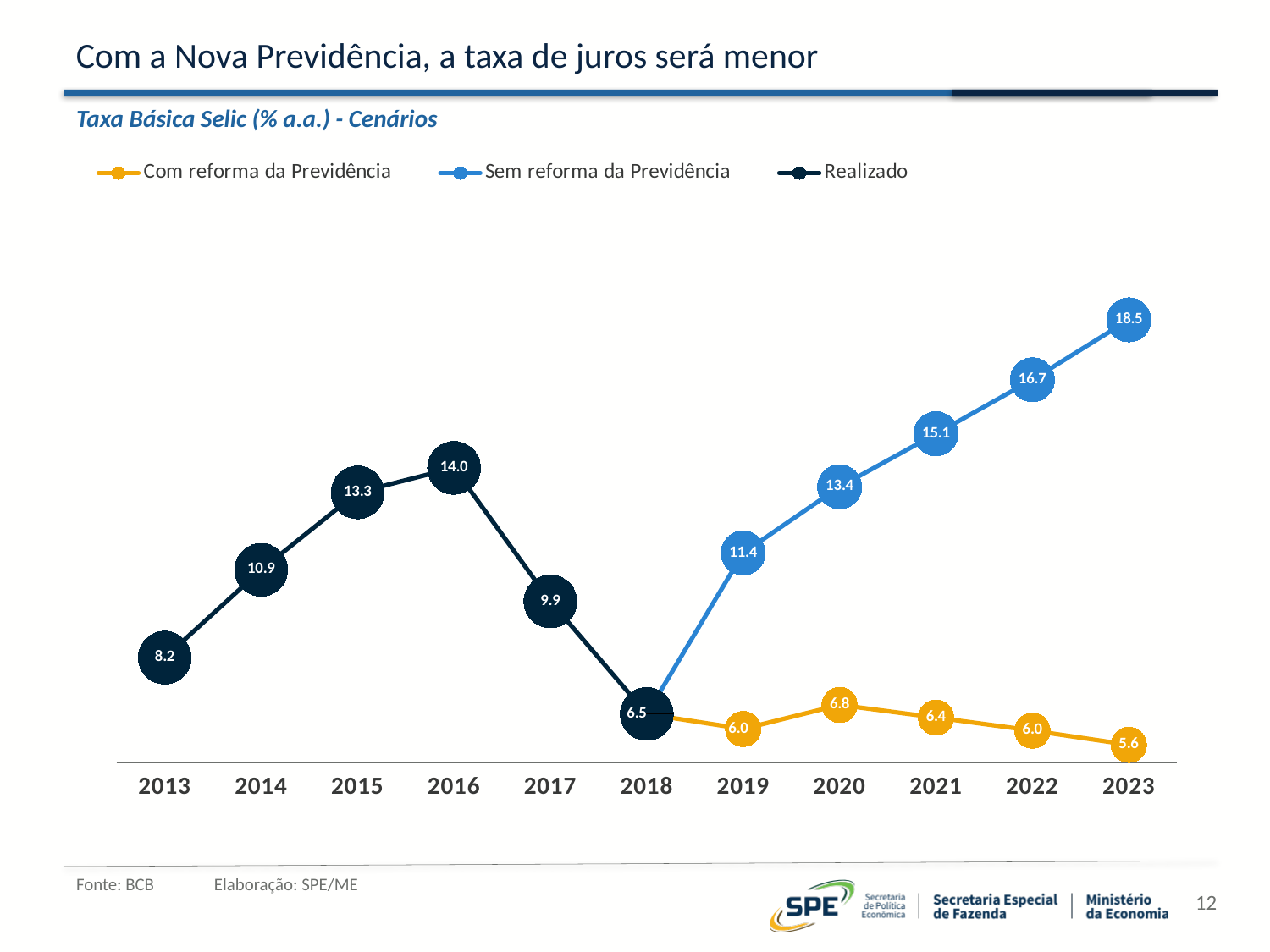
In which year does the Com reforma da Previdência series reach its lowest value? 2023 What is the title of the chart? Taxa Básica Selic (% a.a.) - Cenários What is the value of the Com reforma da Previdência series in 2020? 6.8 Does the Sem reforma da Previdência series rise or fall from 2019 to 2023? Rise What is the difference between the Sem reforma da Previdência and Com reforma da Previdência values in 2023? 12.9 What is the value of the Sem reforma da Previdência series in 2023? 18.5 What kind of chart is shown on the slide? Line chart Which series has the larger value in 2021, Sem reforma da Previdência or Com reforma da Previdência? Sem reforma da Previdência What is the value of the Realizado series in 2016? 14.0 How many years are shown on the x axis? 11 In which year does the Realizado series reach its highest value? 2016 How many series does the legend list? 3